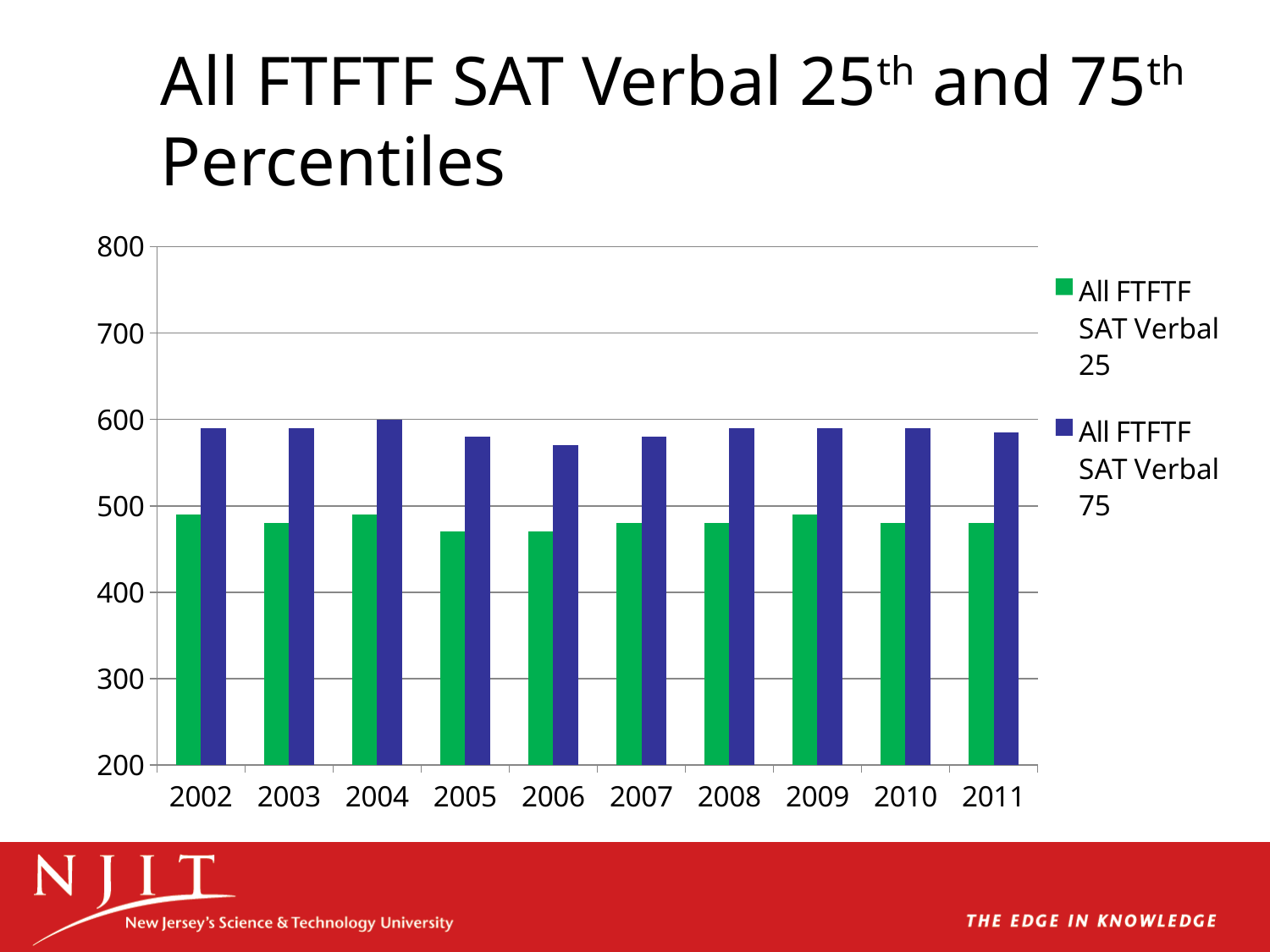
Which year has the highest value for the All FTFTF SAT Verbal 75 series? 2004 Is the All FTFTF SAT Verbal 75 value for 2002 greater or less than 500? greater Is the All FTFTF SAT Verbal 25 value for 2006 greater or less than 400? greater Which colour represents the All FTFTF SAT Verbal 25 series in the chart? green Is the All FTFTF SAT Verbal 25 value for 2005 greater or less than 500? less Which year has the lowest value for the All FTFTF SAT Verbal 75 series? 2006 What is the title of the slide containing the chart? All FTFTF SAT Verbal 25th and 75th Percentiles How many years are shown on the x axis of the chart? 10 What kind of chart is shown on the slide? bar chart Which is larger: the All FTFTF SAT Verbal 75 value for 2004 or for 2006? 2004 How many series does the chart's legend list? 2